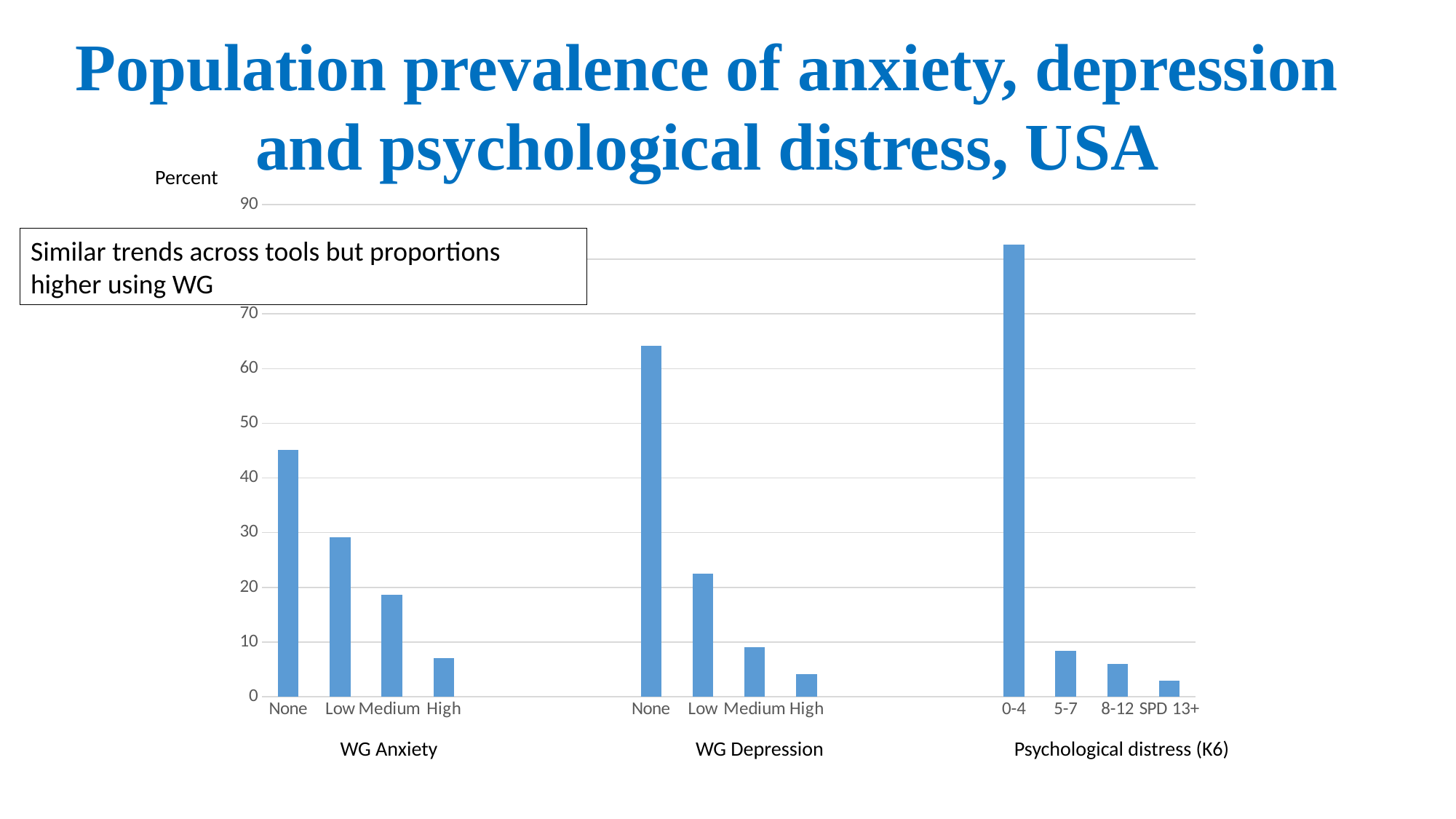
Is the value for High in the WG Depression group greater or less than 10? less Which is larger: the value for Low in WG Anxiety or the value for Low in WG Depression? Low in WG Anxiety How many bars are plotted in total across all three groups? 12 Within the WG Depression group, do the values rise or fall from None to High? fall What label is shown on the vertical axis of the chart? Percent Which category has the tallest bar on the chart? 0-4 (Psychological distress (K6)) Which category has the shortest bar on the chart? SPD 13+ (Psychological distress (K6)) Within the WG Anxiety group, which category has the highest value? None Is the value for None in the WG Anxiety group greater or less than 50? less Is the value for None in the WG Depression group greater or less than 60? greater What kind of chart is shown on the slide? bar chart